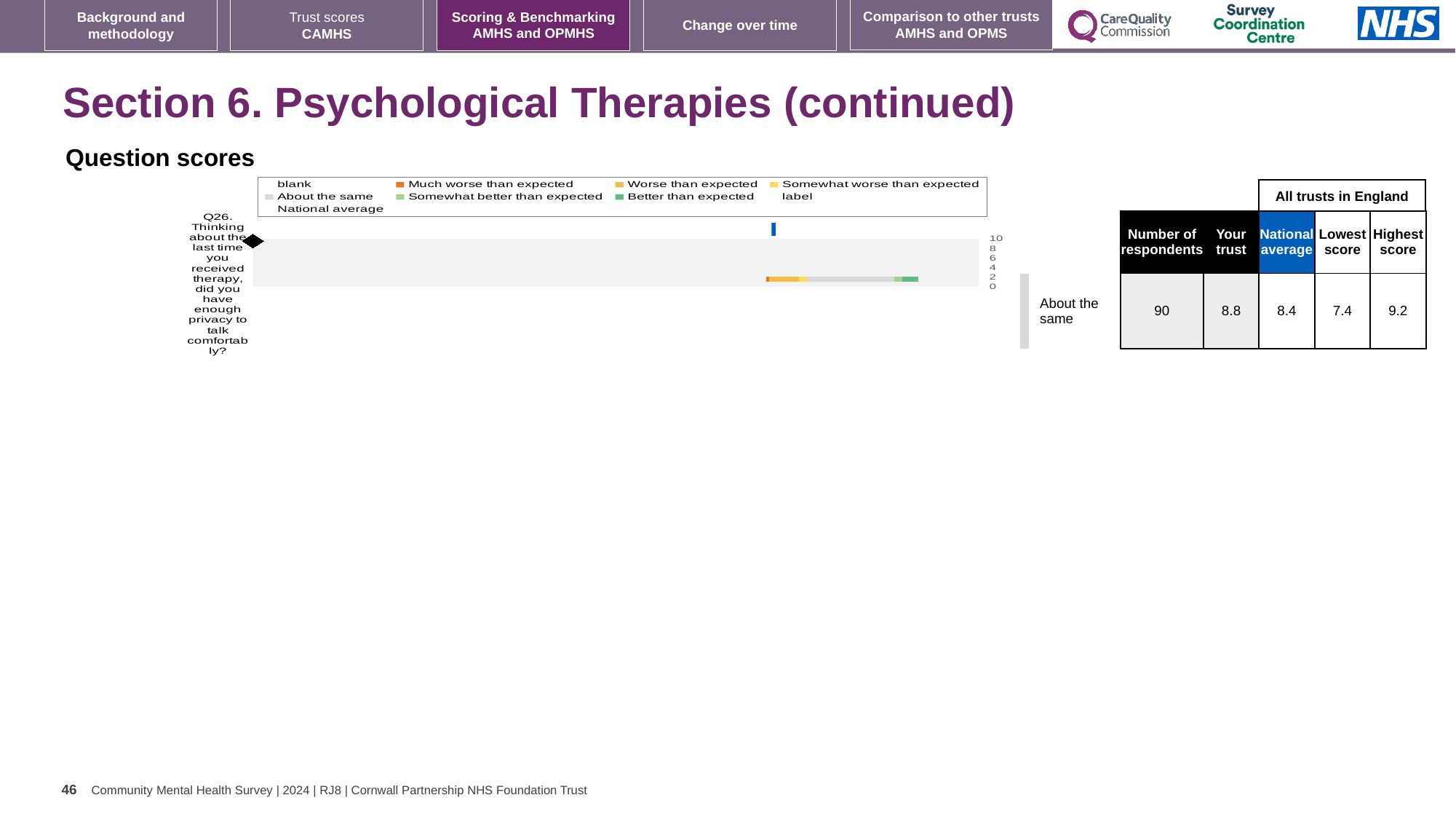
What is the highest tick value shown on the score axis of the Question scores chart? 10 Which question number is plotted in the Question scores chart? Q26 In the Question scores chart legend, which entry is listed immediately after "Much worse than expected"? Worse than expected What kind of chart is shown under "Question scores"? bar chart How many questions (categories) are plotted in the Question scores chart? 1 What benchmark category is shown next to the Question scores chart for Q26? About the same